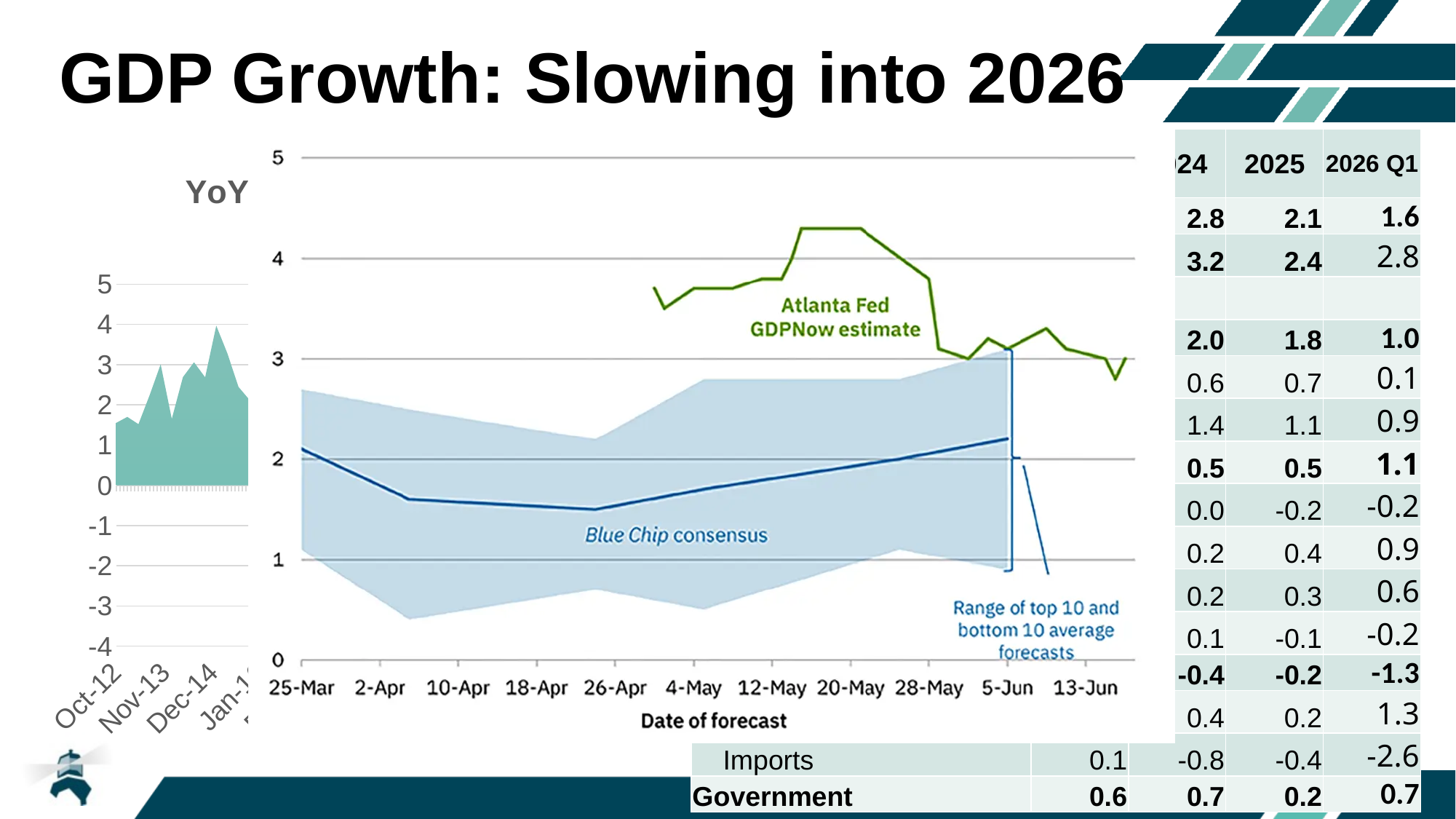
In the central chart, is the Atlanta Fed GDPNow estimate around 20-May greater or less than 4? greater In the central chart, is the Atlanta Fed GDPNow estimate at 4-May greater or less than 3? greater What kind of chart is the central chart showing the Atlanta Fed GDPNow estimate and Blue Chip consensus? line chart What is the x-axis title of the central chart? Date of forecast In the central chart, is the Blue Chip consensus at 26-Apr greater or less than 2? less In the central chart, which is higher on 12-May: the Atlanta Fed GDPNow estimate or the Blue Chip consensus? Atlanta Fed GDPNow estimate In the central chart, what does the shaded blue band represent according to its label? Range of top 10 and bottom 10 average forecasts In the central chart, does the Blue Chip consensus rise or fall between 26-Apr and 5-Jun? rise What kind of chart is the teal chart on the left of the slide? area chart In the central chart, does the Atlanta Fed GDPNow estimate rise or fall between 20-May and 13-Jun? fall How many date labels are shown on the x axis of the central chart? 11